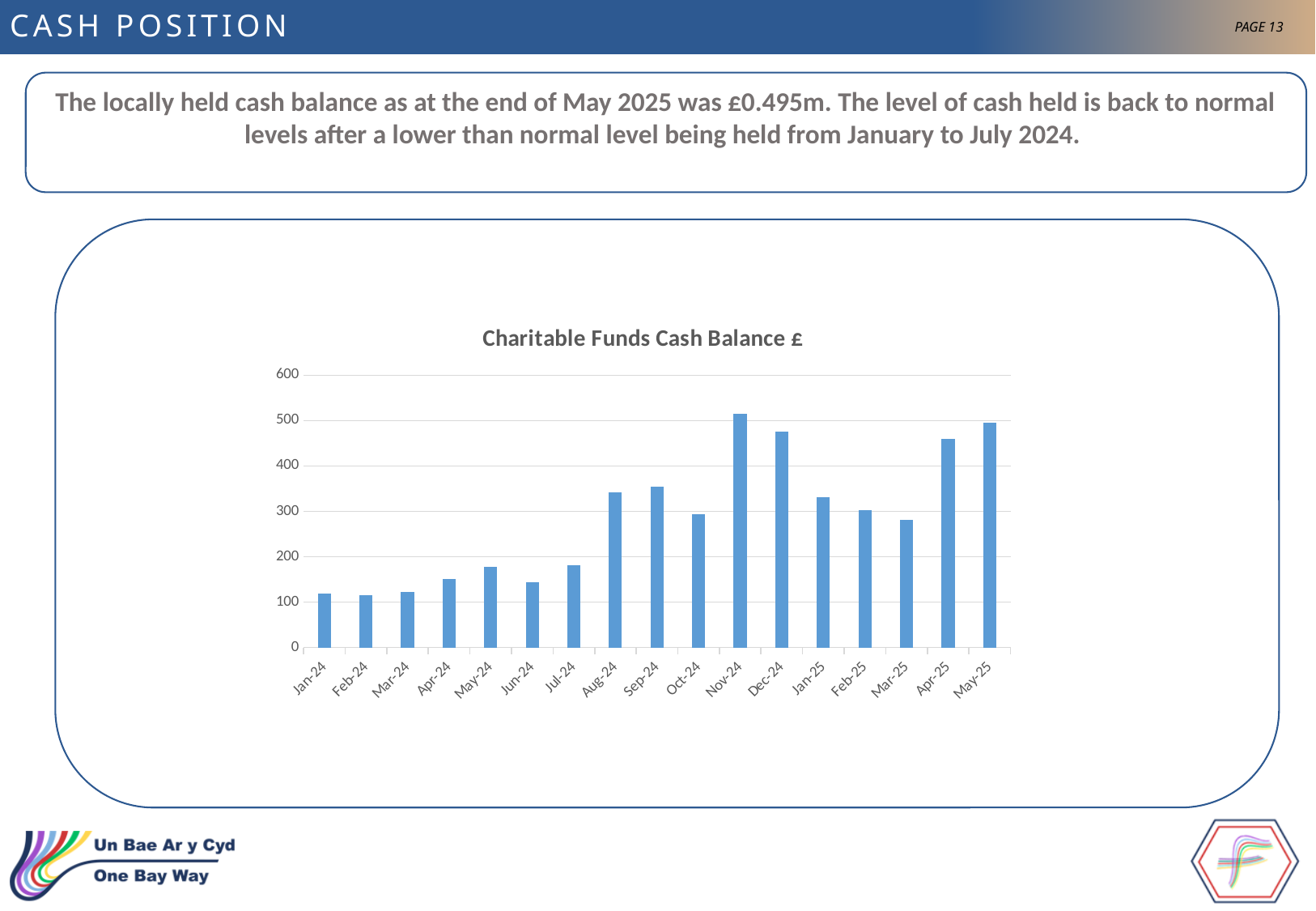
Is the value for Jan-24 greater or less than 200? less Which is larger, the value for Dec-24 or the value for Jan-25? Dec-24 Is the value for Nov-24 greater or less than 500? greater Which month has the highest cash balance? Nov-24 What type of chart is shown on the slide? bar chart Is the value for Apr-25 greater or less than 400? greater Which is larger, the value for May-24 or the value for Jun-24? May-24 Do the values generally rise or fall from Jan-24 to May-25? rise What is the title of the chart? Charitable Funds Cash Balance £ How many months are plotted on the chart? 17